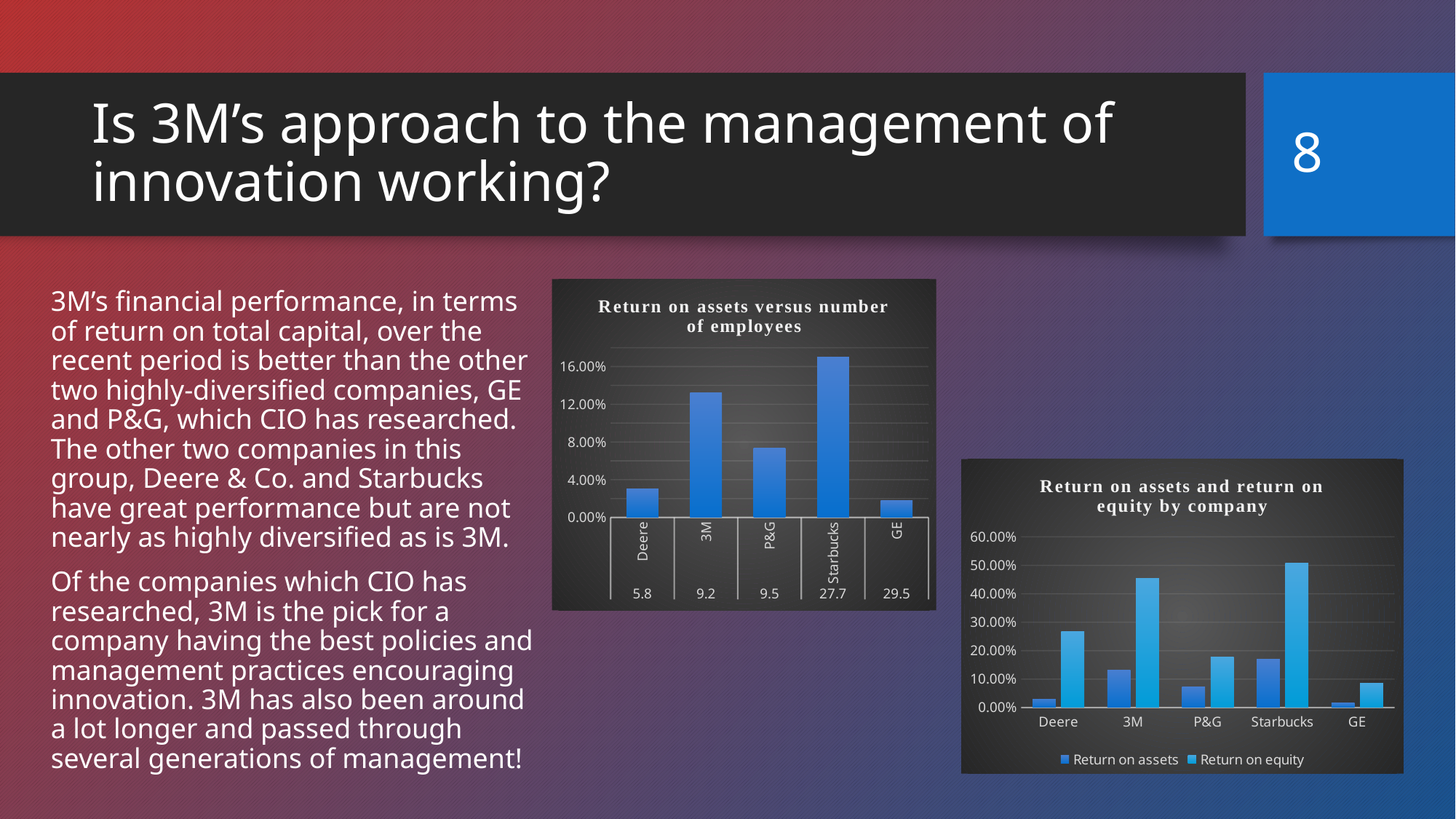
In the 'Return on assets versus number of employees' chart, what number is printed beneath Starbucks on the axis? 27.7 In the 'Return on assets versus number of employees' chart, what number is printed beneath GE on the axis? 29.5 In the 'Return on assets versus number of employees' chart, is the value for 3M greater or less than 12.00%? greater In the 'Return on assets and return on equity by company' chart, how many series does the legend list? 2 In the 'Return on assets and return on equity by company' chart, which is larger for Deere: return on assets or return on equity? Return on equity In the 'Return on assets versus number of employees' chart, is the value for P&G greater or less than 8.00%? less In the 'Return on assets versus number of employees' chart, which company has the lowest return on assets? GE What type of chart is the 'Return on assets versus number of employees' chart? bar chart In the 'Return on assets and return on equity by company' chart, is the return on equity for 3M greater or less than 40.00%? greater In the 'Return on assets and return on equity by company' chart, which company has the highest return on equity? Starbucks In the 'Return on assets versus number of employees' chart, which company has the highest return on assets? Starbucks In the 'Return on assets versus number of employees' chart, how many companies are shown? 5